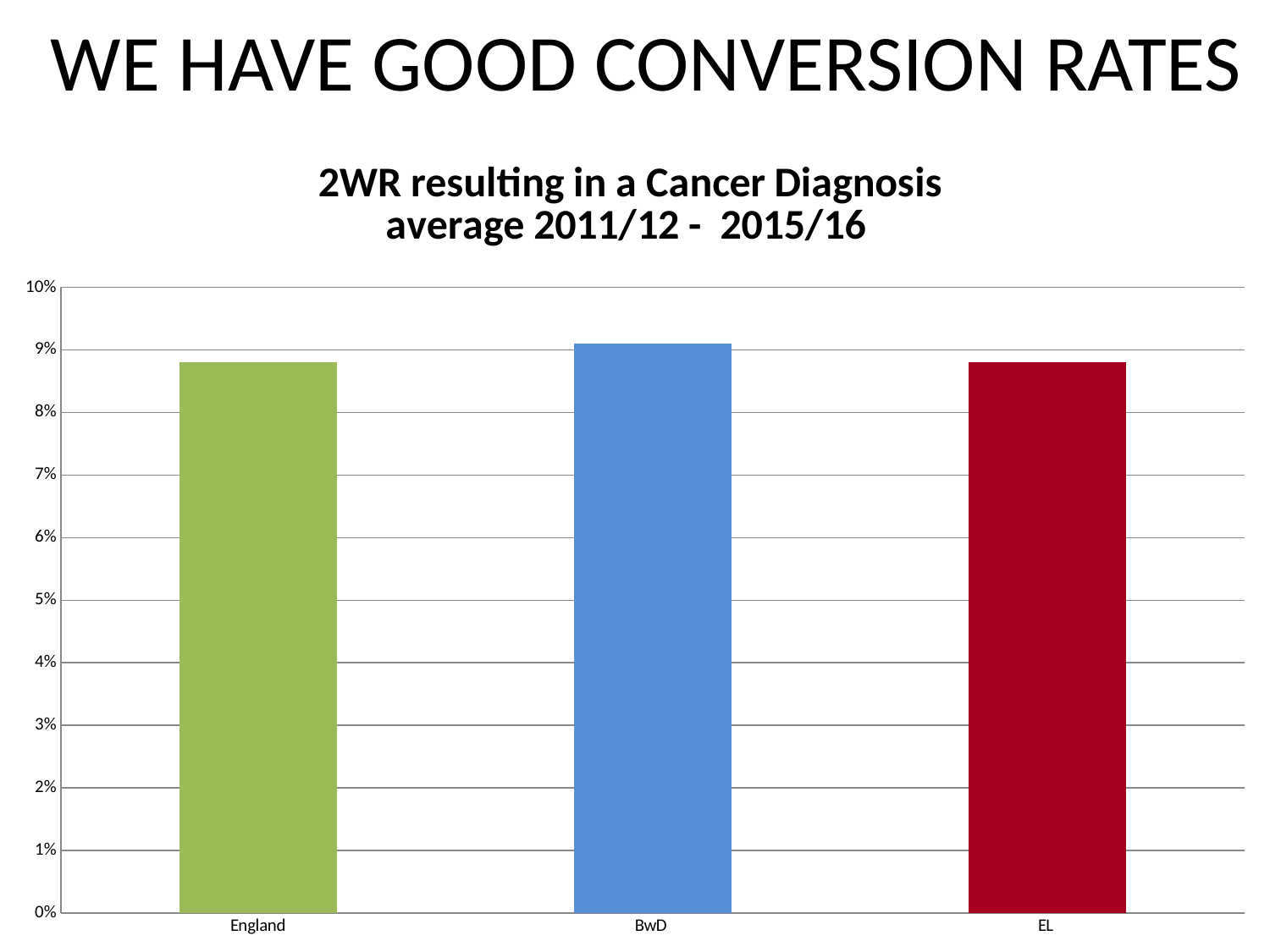
What colour is the bar for BwD? blue Is the value for BwD greater or less than 8%? greater How many categories are plotted on the chart? 3 What is the highest value shown on the vertical axis? 10% What is the title of the chart? 2WR resulting in a Cancer Diagnosis average 2011/12 - 2015/16 Which category has the highest value on the chart? BwD Is the value for England greater or less than 9%? less Which is larger, the value for BwD or the value for England? BwD Is the value for EL greater or less than 9%? less What kind of chart is shown on the slide? bar chart